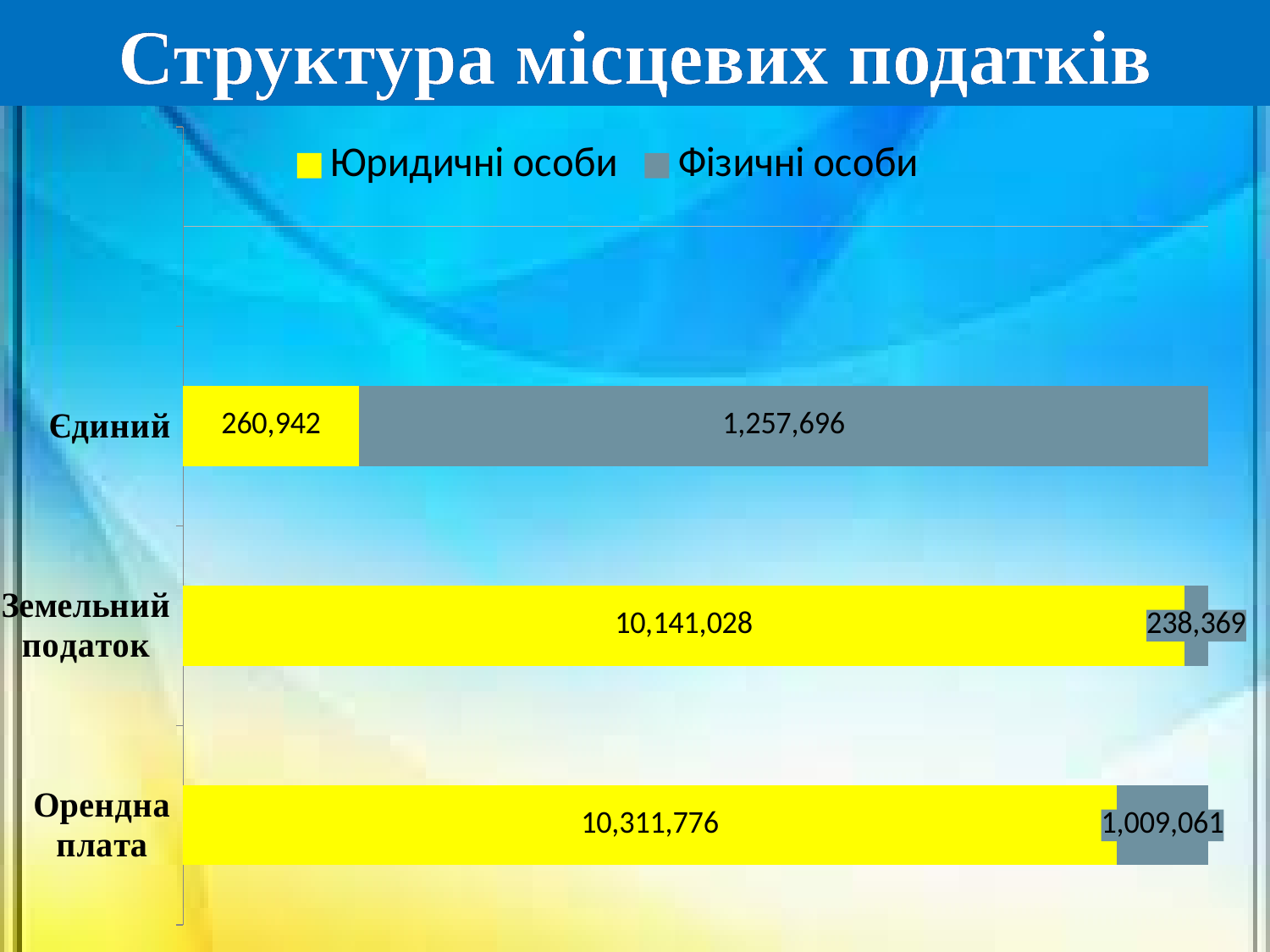
What is the value for Юридичні особи in the Єдиний category? 260,942 How many categories are shown in the chart? 3 What is the total of the Земельний податок bar (Юридичні особи plus Фізичні особи)? 10,379,397 Which category has the highest value for Фізичні особи? Єдиний Which category has the highest value for Юридичні особи? Орендна плата Which category has the lowest value for Фізичні особи? Земельний податок What is the difference between Фізичні особи and Юридичні особи in the Єдиний category? 996,754 What type of chart is shown on the slide? Stacked bar chart What is the value for Юридичні особи in the Орендна плата category? 10,311,776 In the Орендна плата category, which is larger: Юридичні особи or Фізичні особи? Юридичні особи How many series does the legend list? 2 What is the value for Фізичні особи in the Земельний податок category? 238,369